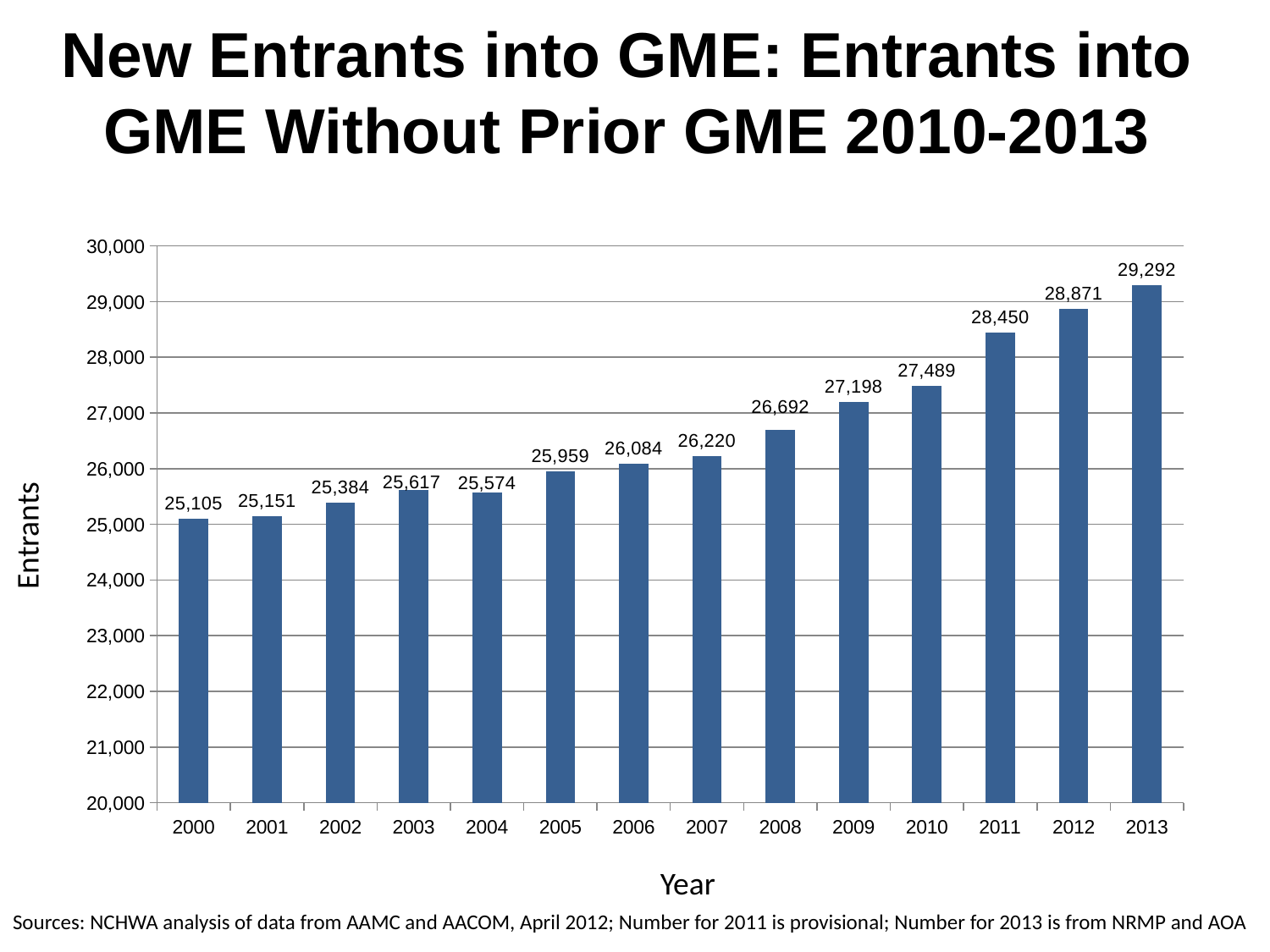
What kind of chart is shown on the slide? bar chart Is the value for 2008 greater or less than 27,000? less Which year has the lowest number of entrants? 2000 How many years are shown on the x axis? 14 Which year has the highest number of entrants? 2013 What is the label of the y axis? Entrants Which year has more entrants, 2003 or 2004? 2003 What is the difference in entrants between 2010 and 2009? 291 What is the number of entrants in 2000? 25,105 What is the number of entrants in 2005? 25,959 What is the number of entrants in 2013? 29,292 What is the difference in entrants between 2013 and 2012? 421